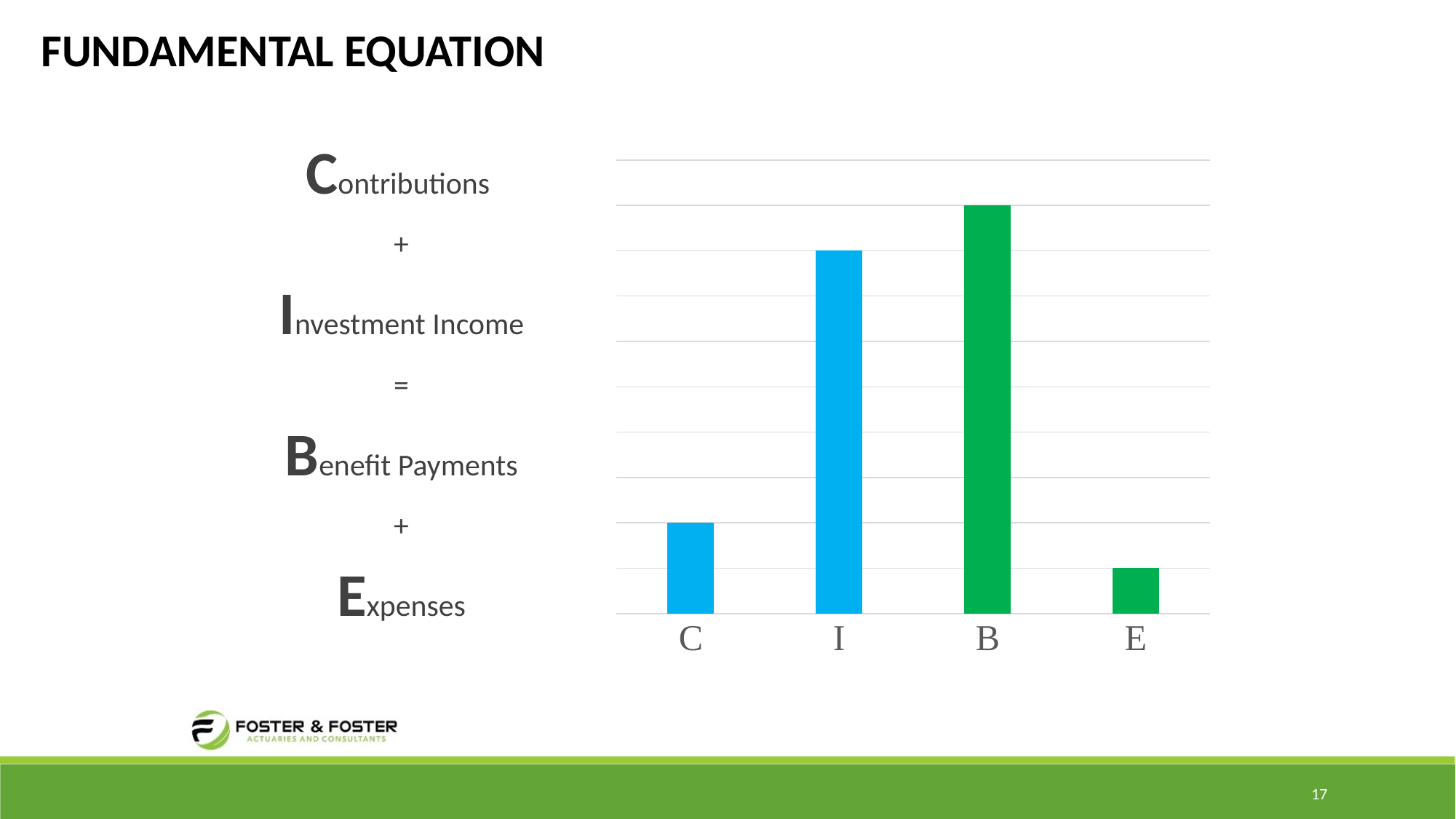
What kind of chart is shown on the slide? Bar chart Which category has the shortest bar in the chart? E Which bar is taller, C or I? I Which bar is taller, C or E? C What colour are the bars for C and I in the chart? Blue Which bar is taller, B or I? B How many categories are shown on the x axis of the chart? 4 Which category has the tallest bar in the chart? B What are the category labels on the x axis of the chart, from left to right? C, I, B, E